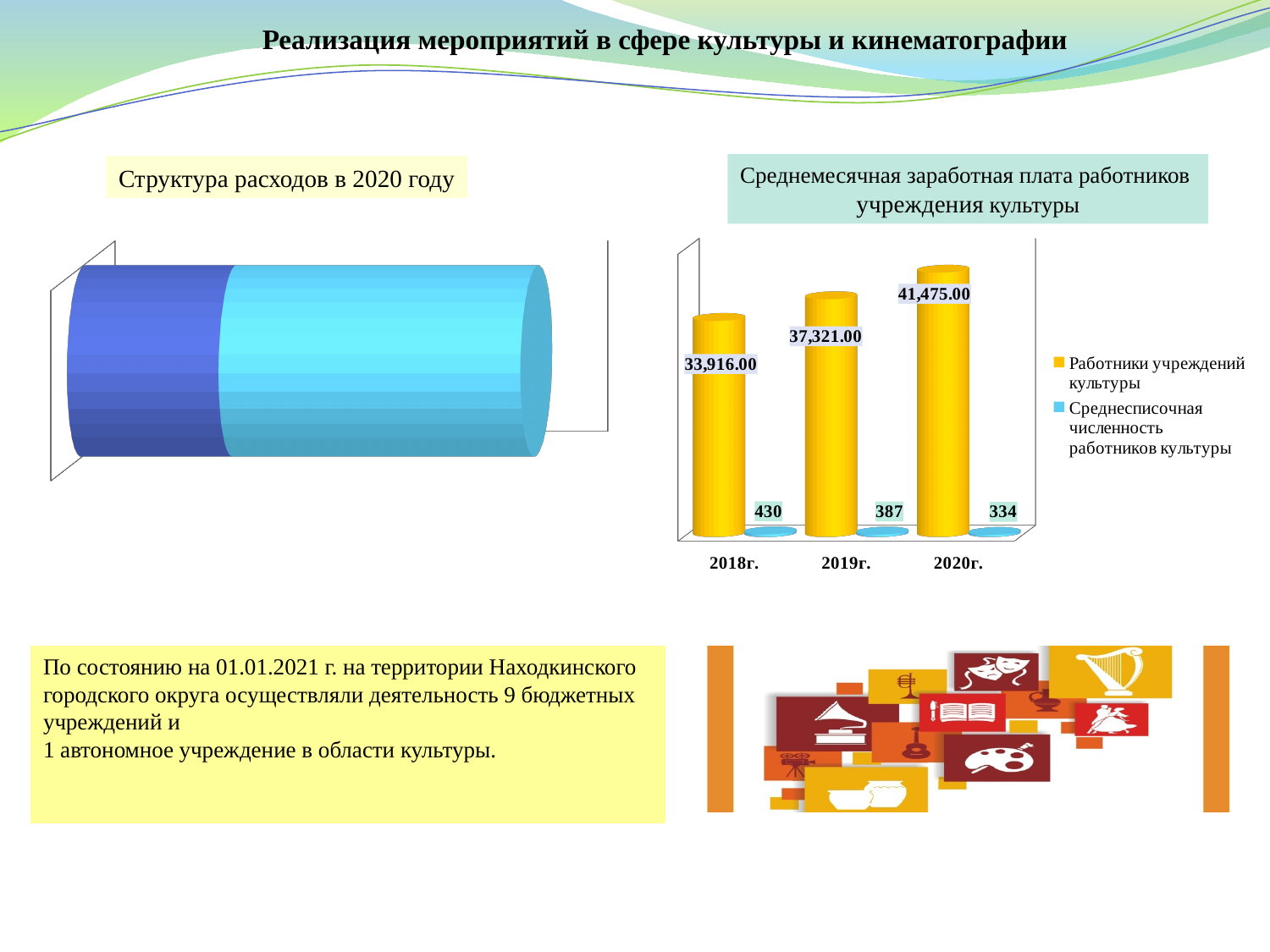
In the chart 'Среднемесячная заработная плата работников учреждения культуры', what is the Среднесписочная численность работников культуры in 2019г.? 387 In the chart 'Среднемесячная заработная плата работников учреждения культуры', what is the value for Работники учреждений культуры in 2018г.? 33,916.00 In the chart 'Среднемесячная заработная плата работников учреждения культуры', do the Среднесписочная численность работников культуры values rise or fall from 2018г. to 2020г.? fall In the chart 'Среднемесячная заработная плата работников учреждения культуры', which year has the highest value for Работники учреждений культуры? 2020г. In the chart 'Среднемесячная заработная плата работников учреждения культуры', what is the difference between the Работники учреждений культуры values for 2020г. and 2018г.? 7,559.00 How many years are shown on the x axis of the chart 'Среднемесячная заработная плата работников учреждения культуры'? 3 What kind of chart is 'Среднемесячная заработная плата работников учреждения культуры'? bar chart In the chart 'Среднемесячная заработная плата работников учреждения культуры', which year has the lowest Среднесписочная численность работников культуры? 2020г. In the chart 'Среднемесячная заработная плата работников учреждения культуры', by how much did the Среднесписочная численность работников культуры fall from 2018г. to 2020г.? 96 How many series does the legend of the chart 'Среднемесячная заработная плата работников учреждения культуры' list? 2 In the chart 'Среднемесячная заработная плата работников учреждения культуры', what is the value for Работники учреждений культуры in 2020г.? 41,475.00 In the chart 'Среднемесячная заработная плата работников учреждения культуры', which year has the larger Работники учреждений культуры value, 2018г. or 2019г.? 2019г.